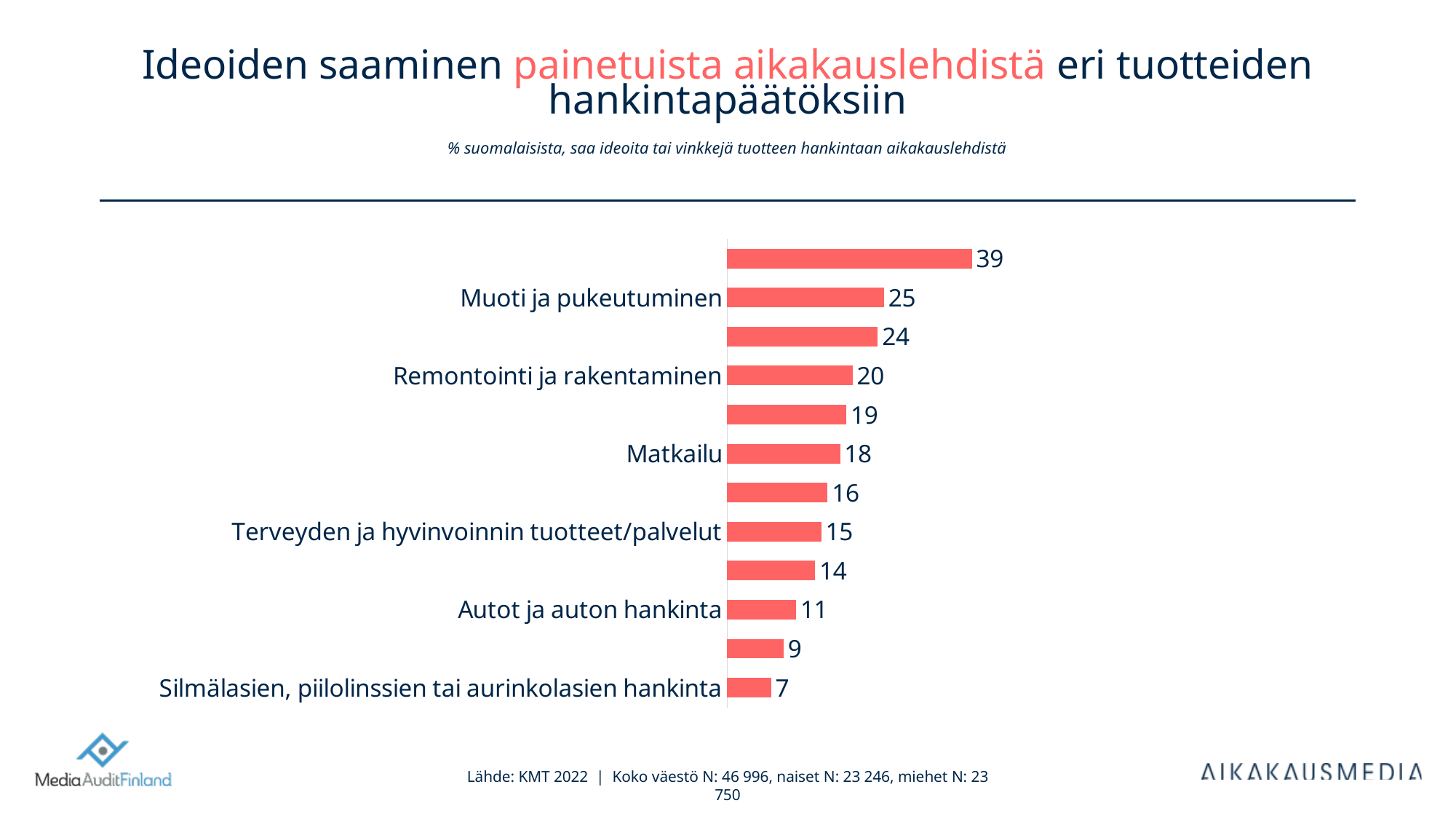
How many bars are plotted on the chart? 12 What is the difference between the values for Muoti ja pukeutuminen and Matkailu? 7 What is the highest value shown on the chart? 39 What is the value for Autot ja auton hankinta? 11 What is the value for Remontointi ja rakentaminen? 20 Which is larger, the value for Remontointi ja rakentaminen or the value for Autot ja auton hankinta? Remontointi ja rakentaminen Which labelled category has the lowest value? Silmälasien, piilolinssien tai aurinkolasien hankinta What is the value for Matkailu? 18 Do the values increase or decrease going from the top bar to the bottom bar? Decrease What kind of chart is shown on the slide? Bar chart What is the value for Muoti ja pukeutuminen? 25 What is the value for Terveyden ja hyvinvoinnin tuotteet/palvelut? 15